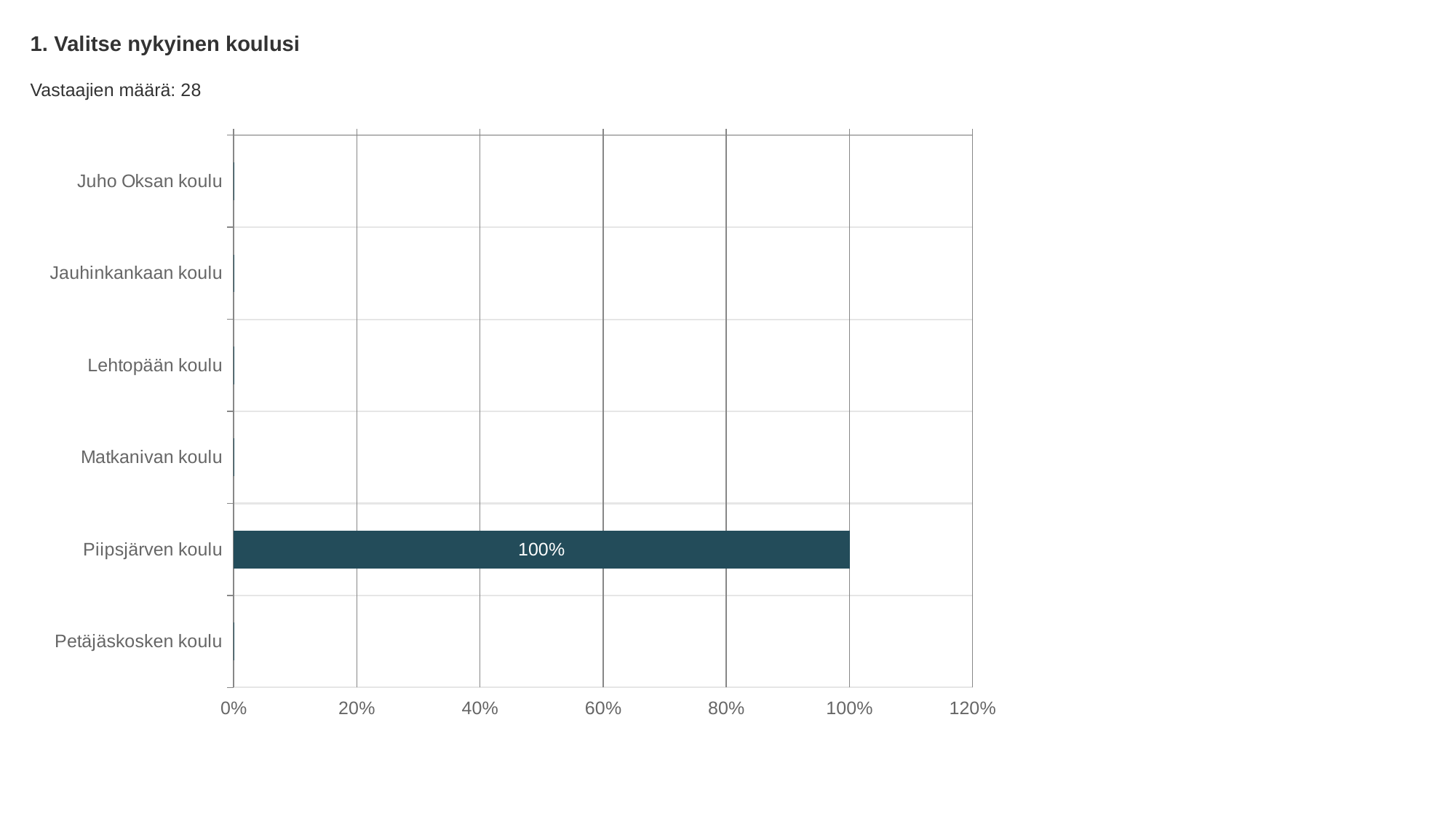
Which is larger, the value for Piipsjärven koulu or the value for Juho Oksan koulu? Piipsjärven koulu What kind of chart is shown on the slide? Bar chart How many categories are shown on the chart? 6 How many respondents (Vastaajien määrä) are stated on the slide? 28 Which category has the highest value? Piipsjärven koulu What is the highest value shown on the x axis? 120% What is the value for Piipsjärven koulu? 100% Is the value for Piipsjärven koulu greater or less than 80%? greater What is the title of the chart? 1. Valitse nykyinen koulusi